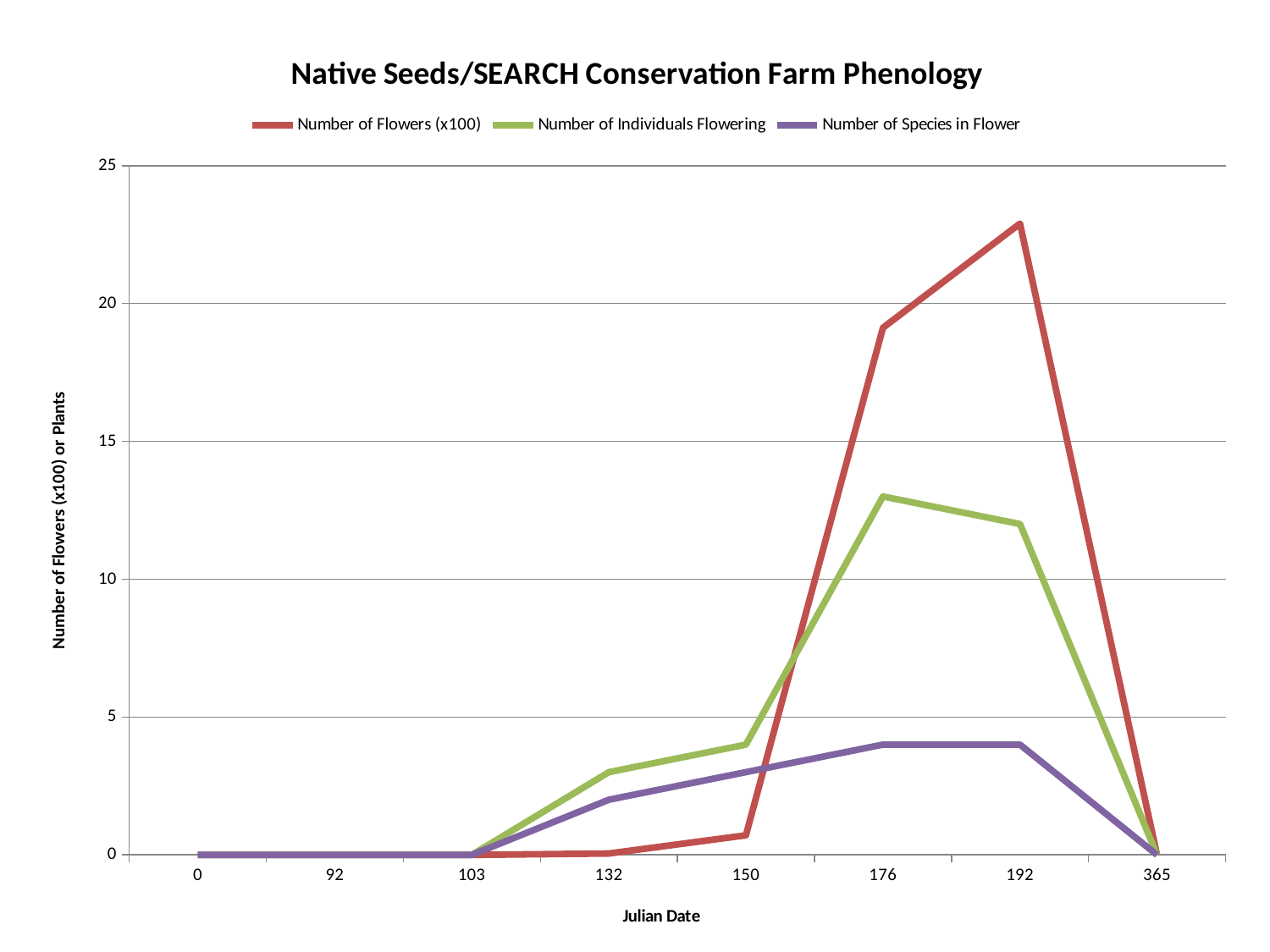
Is the value of Number of Flowers (x100) at Julian Date 192 greater or less than 20? greater What kind of chart is shown on the slide? line chart What is the value of Number of Species in Flower at Julian Date 365? 0 How many series does the legend list? 3 At which Julian Date does Number of Individuals Flowering reach its highest value? 176 Is the value of Number of Species in Flower at Julian Date 176 greater or less than 5? less How many Julian Date points are labelled on the x axis? 8 At Julian Date 192, which is larger: Number of Flowers (x100) or Number of Individuals Flowering? Number of Flowers (x100) At Julian Date 150, which is larger: Number of Individuals Flowering or Number of Flowers (x100)? Number of Individuals Flowering Is the value of Number of Individuals Flowering at Julian Date 176 greater or less than 10? greater At which Julian Date does Number of Flowers (x100) reach its highest value? 192 Does Number of Flowers (x100) rise or fall between Julian Date 192 and 365? fall